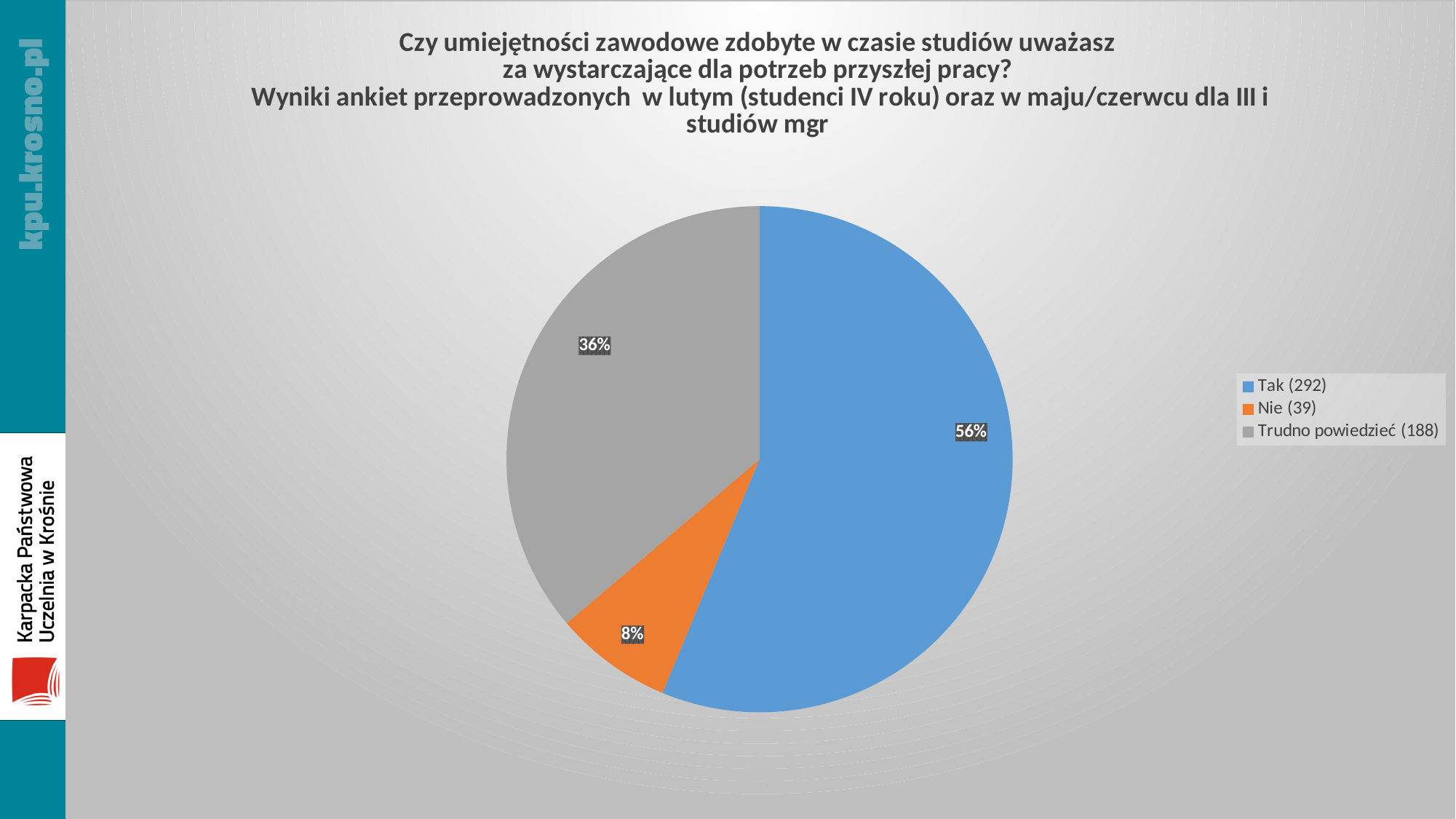
How many entries does the legend list? 3 Which category has the smallest share of the pie? Nie (39) How many respondents answered "Tak" according to the legend? 292 How many slices does the pie chart have? 3 What is the difference in percentage points between the "Tak (292)" slice and the "Trudno powiedzieć (188)" slice? 20 percentage points What percentage of the pie does the "Nie (39)" slice represent? 8% Which slice is larger: "Nie (39)" or "Trudno powiedzieć (188)"? Trudno powiedzieć (188) What kind of chart is shown on the slide? pie chart What percentage of the pie does the "Tak (292)" slice represent? 56% What colour is the "Nie (39)" slice? orange Which category has the largest share of the pie? Tak (292) What percentage of the pie does the "Trudno powiedzieć (188)" slice represent? 36%